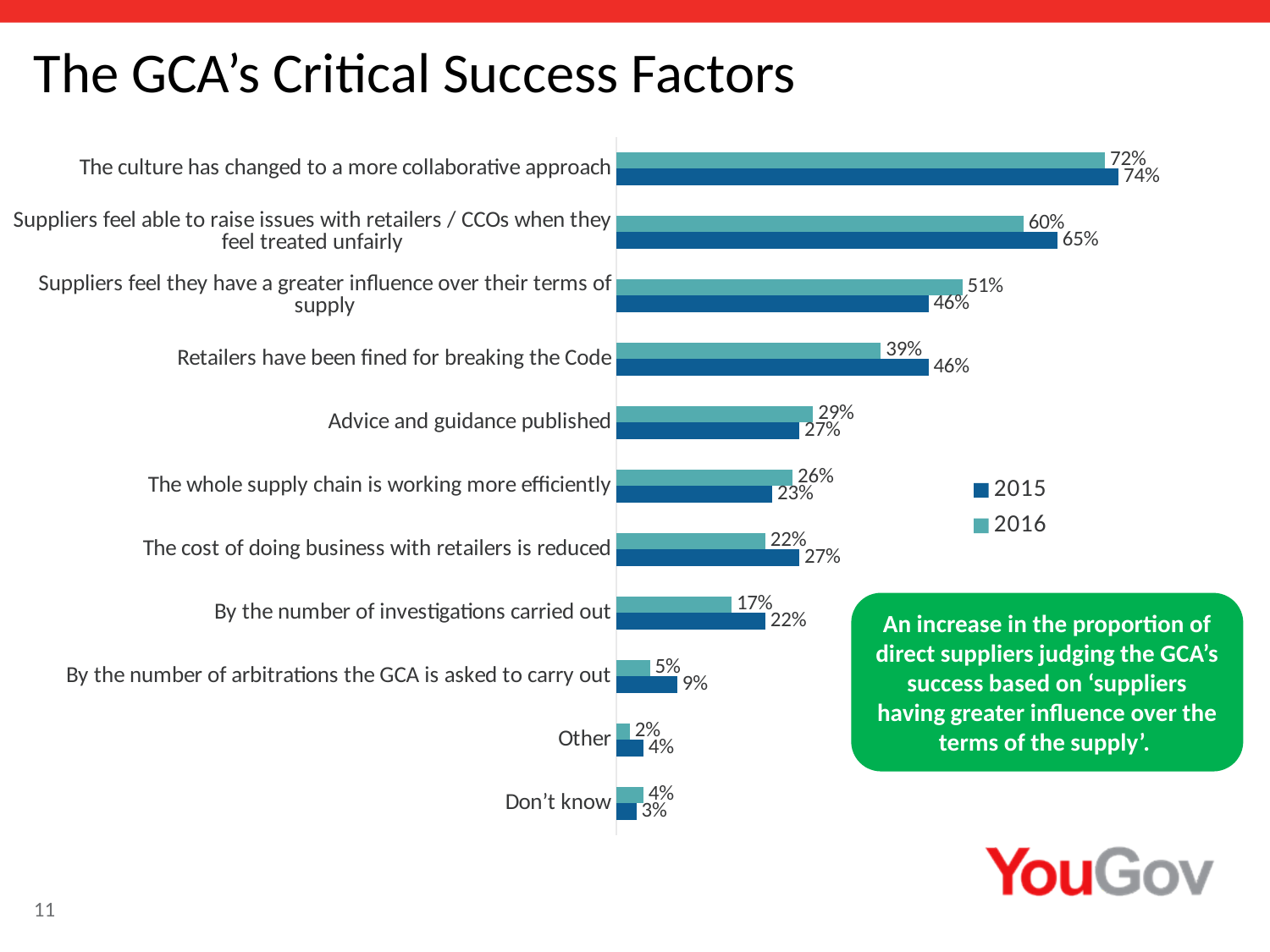
Which series is shown in dark blue in the legend? 2015 What is the difference between the 2015 and 2016 values for 'Retailers have been fined for breaking the Code'? 7% What kind of chart is shown on the slide? Bar chart How many series does the legend list? 2 What is the 2016 value for 'Retailers have been fined for breaking the Code'? 39% How many categories are plotted on the chart? 11 What is the 2015 value for 'The culture has changed to a more collaborative approach'? 74% What is the 2016 value for 'Suppliers feel they have a greater influence over their terms of supply'? 51% For 'The cost of doing business with retailers is reduced', which year has the larger value, 2015 or 2016? 2015 What is the 2015 value for 'By the number of arbitrations the GCA is asked to carry out'? 9% Which category has the lowest 2016 value? Other Which category has the highest 2016 value? The culture has changed to a more collaborative approach